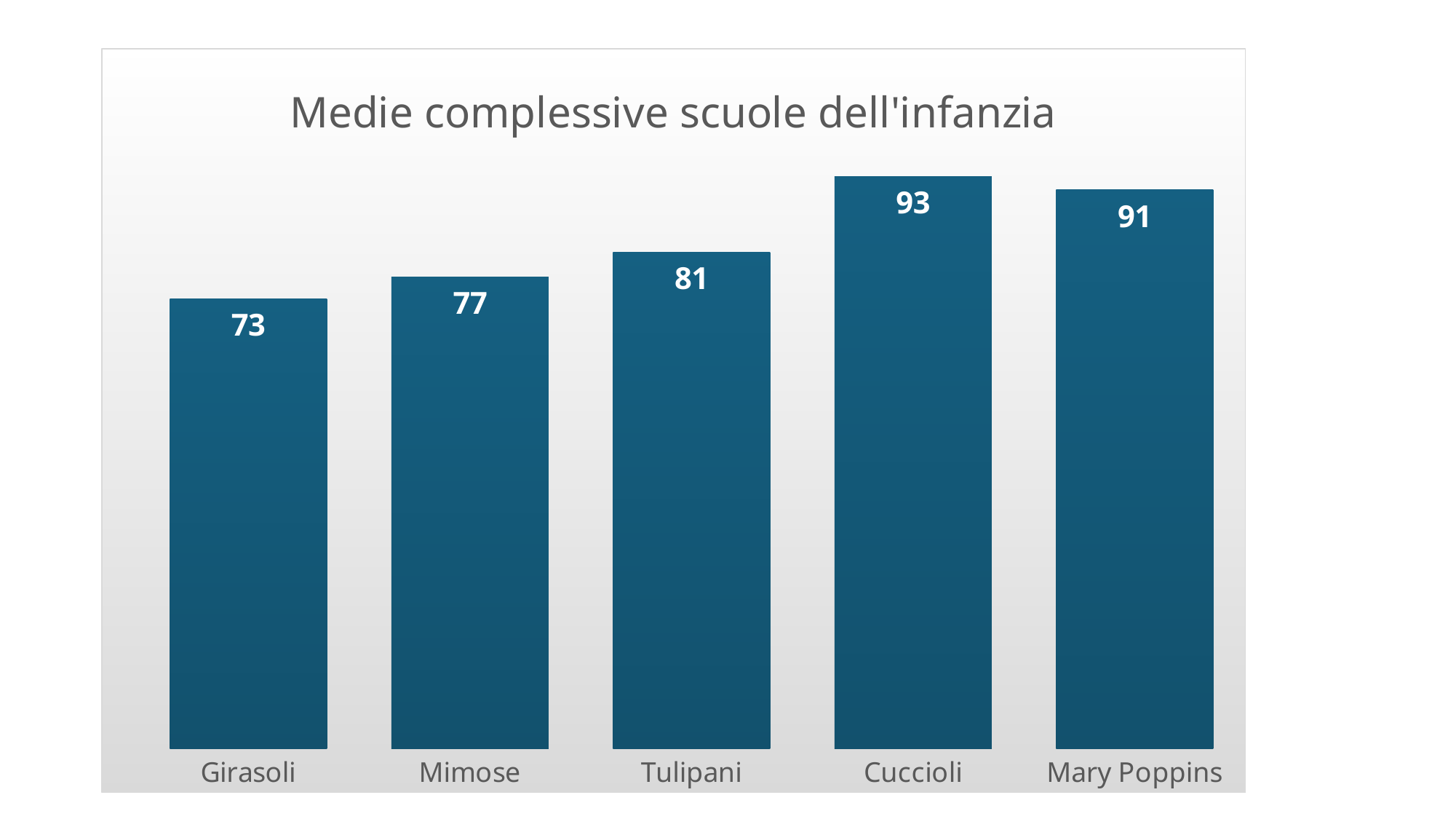
What is the difference between the values for Tulipani and Mimose? 4 Which category has the lowest value? Girasoli How many categories are shown in the chart? 5 What is the difference between the values for Cuccioli and Girasoli? 20 What is the title of the chart? Medie complessive scuole dell'infanzia What kind of chart is this? Bar chart What is the value for Tulipani? 81 Which category has the highest value? Cuccioli What is the value for Mimose? 77 What is the value for Mary Poppins? 91 Which is larger, the value for Mary Poppins or the value for Tulipani? Mary Poppins What is the value for Girasoli? 73